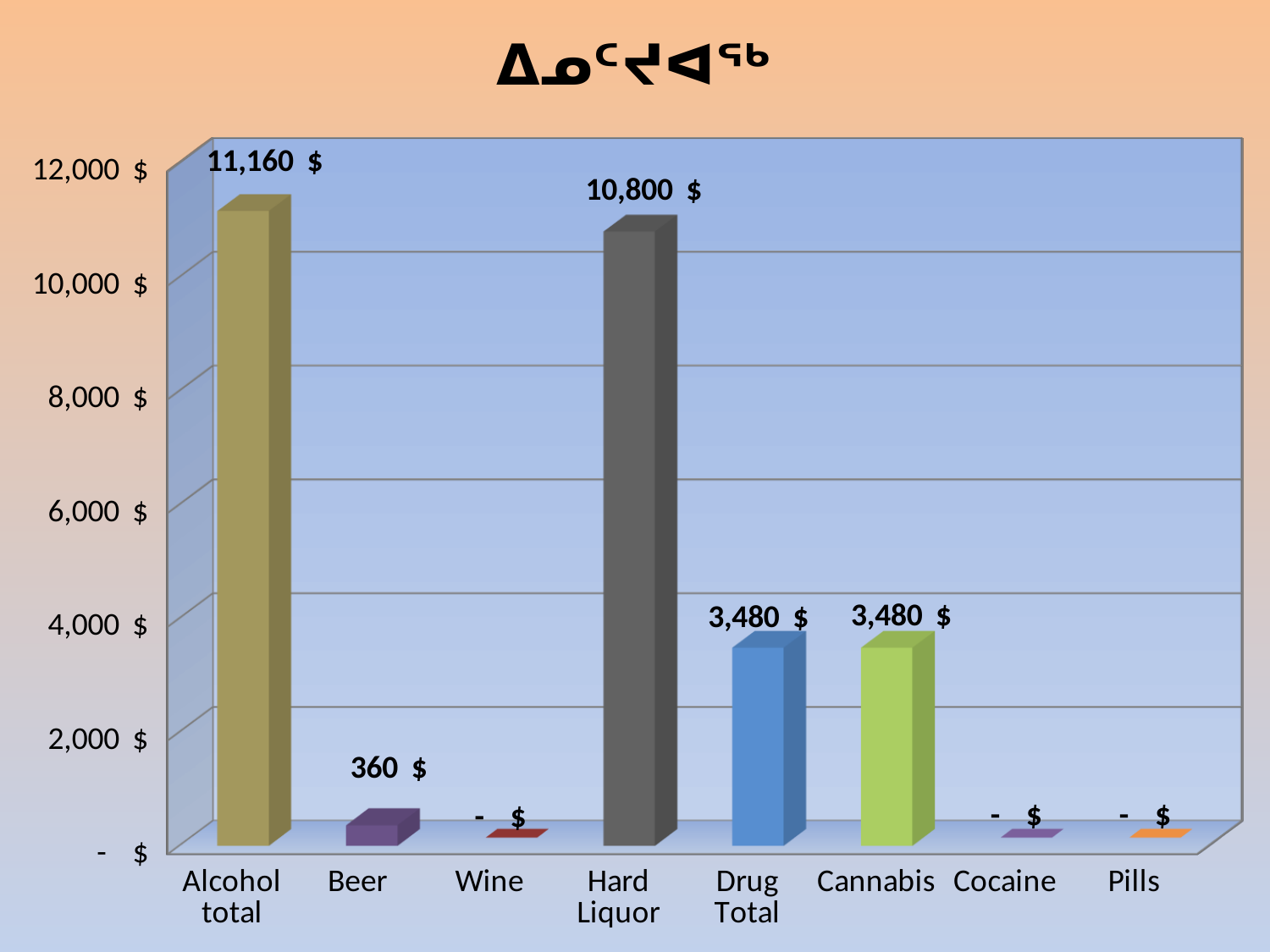
Which category has the highest value? Alcohol total What is the value for Beer? 360 $ What is the value for Alcohol total? 11,160 $ What is the difference between Alcohol total and Drug Total? 7,680 $ What is the value for Hard Liquor? 10,800 $ How many categories are shown on the x axis? 8 What is the difference between Alcohol total and Hard Liquor? 360 $ What kind of chart is shown on the slide? bar chart Which is larger, Hard Liquor or Drug Total? Hard Liquor Is the value for Beer greater or less than 2,000 $? less What is the value for Cannabis? 3,480 $ What colour is the Hard Liquor bar? dark gray